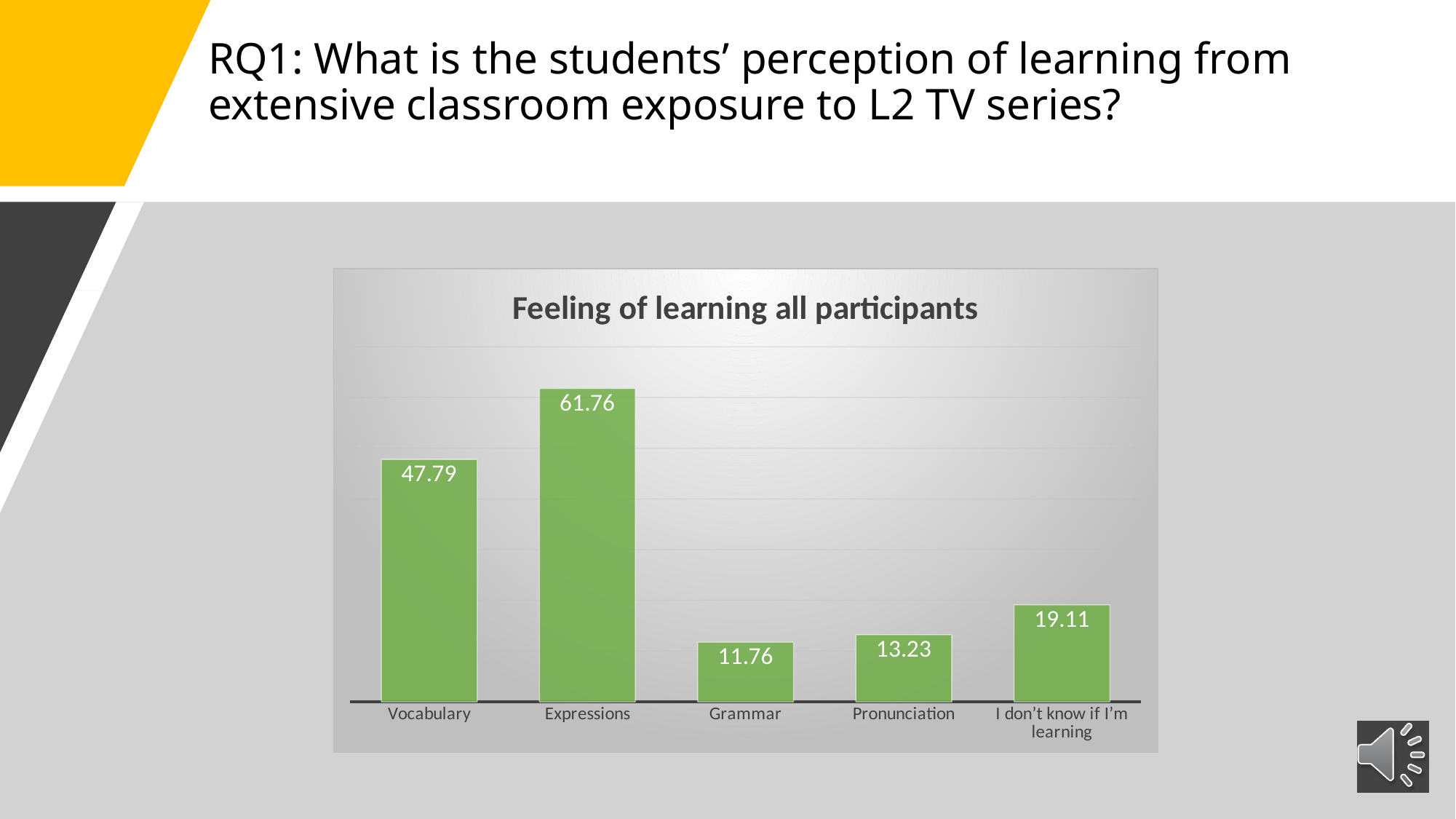
How many categories are shown on the x axis? 5 What is the value for Pronunciation? 13.23 What is the value for 'I don't know if I'm learning'? 19.11 Which category has the highest value? Expressions What is the difference between the values for Expressions and Vocabulary? 13.97 What is the value for Grammar? 11.76 Which category has the lowest value? Grammar What is the title of the chart? Feeling of learning all participants Which is larger, the value for Pronunciation or the value for Grammar? Pronunciation What is the value for Expressions? 61.76 What is the value for Vocabulary? 47.79 What kind of chart is shown on the slide? Bar chart